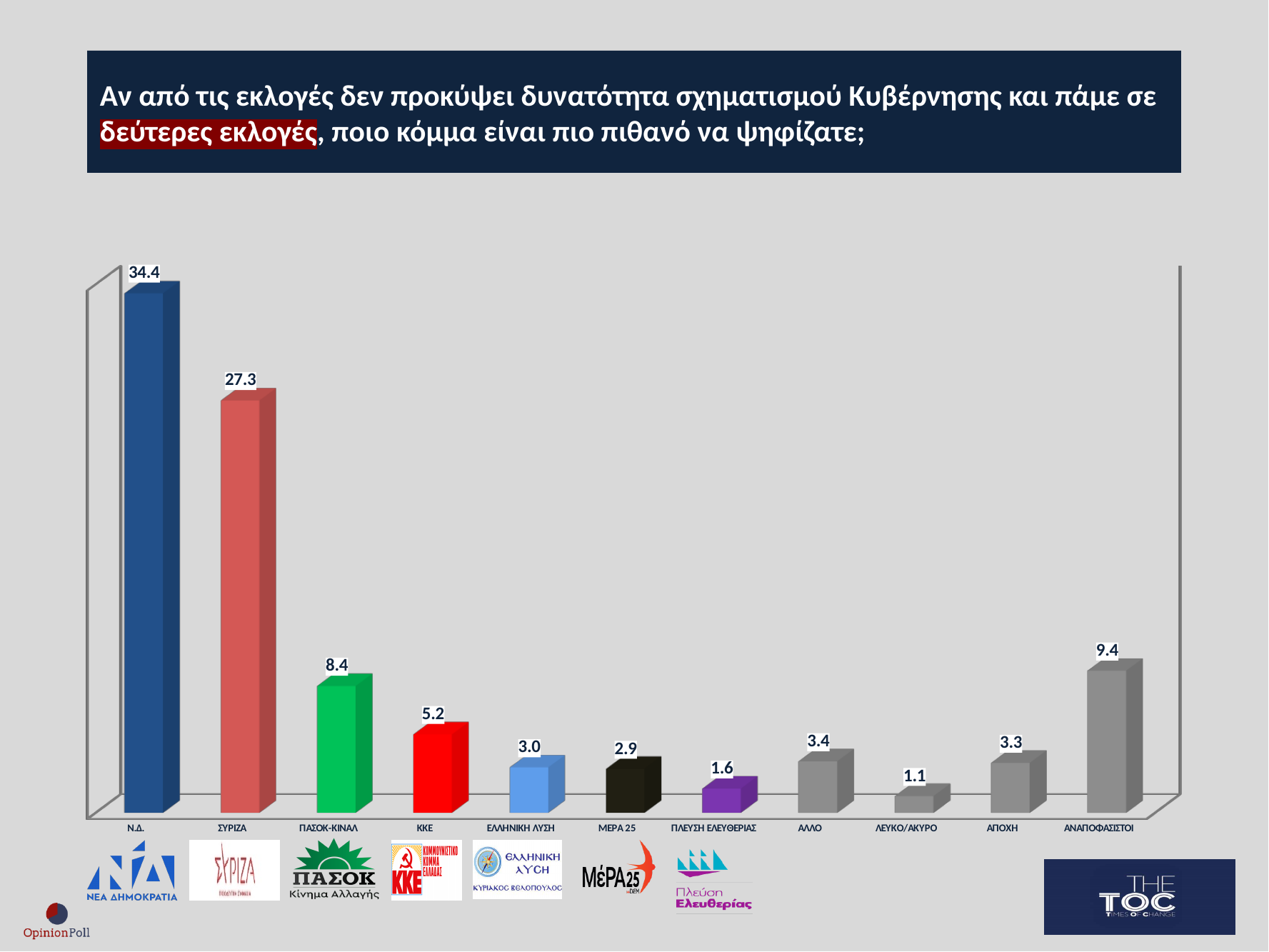
Which category has the lowest value? ΛΕΥΚΟ/ΑΚΥΡΟ What is the difference between the values for Ν.Δ. and ΣΥΡΙΖΑ? 7.1 What is the difference between the values for ΠΑΣΟΚ-ΚΙΝΑΛ and ΚΚΕ? 3.2 Which is larger, the value for ΑΝΑΠΟΦΑΣΙΣΤΟΙ or the value for ΠΑΣΟΚ-ΚΙΝΑΛ? ΑΝΑΠΟΦΑΣΙΣΤΟΙ How many categories are shown on the chart? 11 What is the value for ΑΝΑΠΟΦΑΣΙΣΤΟΙ? 9.4 What colour is the bar for ΚΚΕ? Red What is the value for ΣΥΡΙΖΑ? 27.3 What is the value for ΠΛΕΥΣΗ ΕΛΕΥΘΕΡΙΑΣ? 1.6 What kind of chart is shown on the slide? Bar chart Which category has the highest value? Ν.Δ. What is the value for Ν.Δ.? 34.4